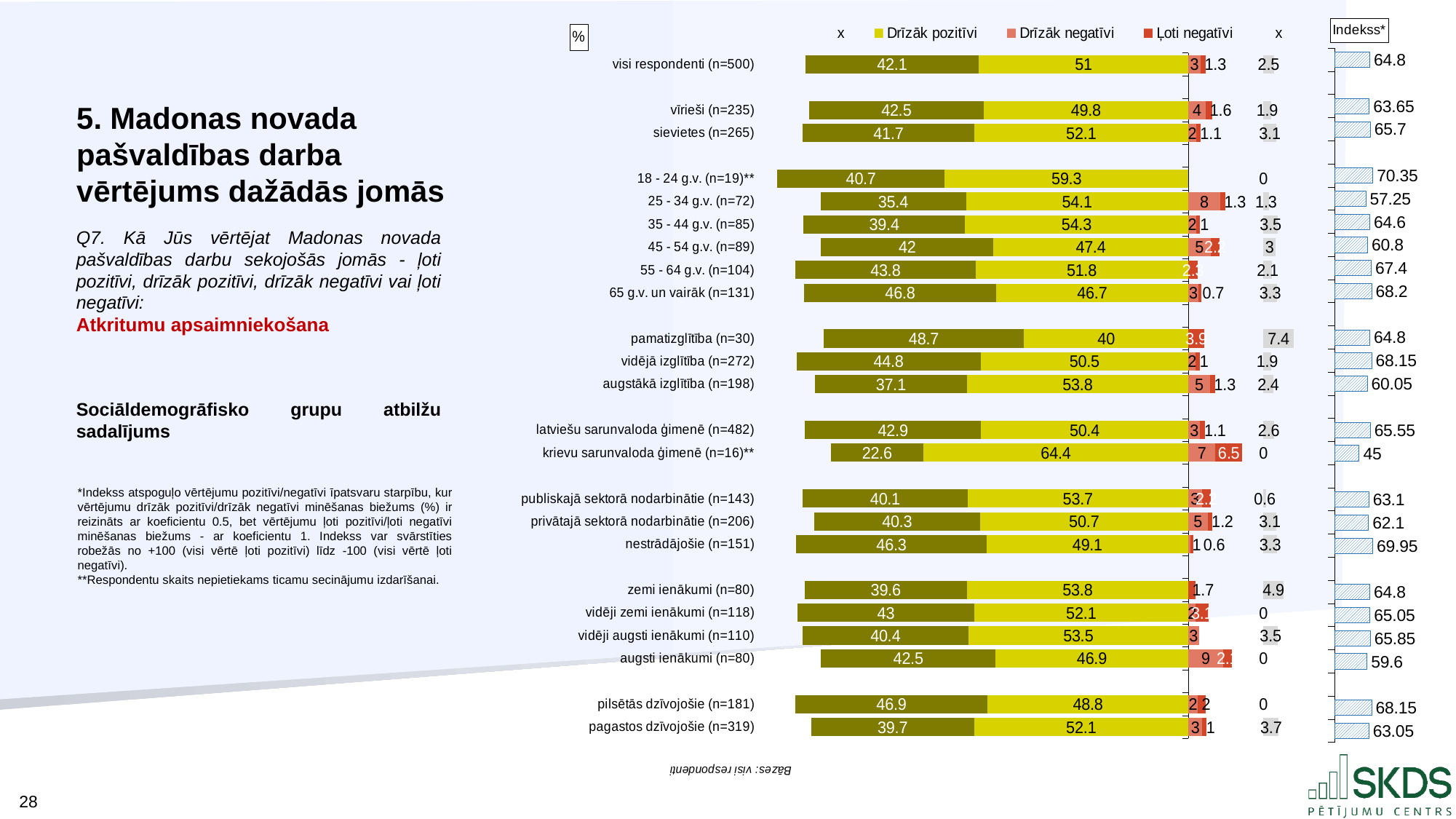
Which group has the highest Indekss* value? 18 - 24 g.v. (n=19)** Which group has the highest 'Drīzāk pozitīvi' value? krievu sarunvaloda ģimenē (n=16)** What type of chart is shown on the slide? Stacked bar chart What is the 'Drīzāk pozitīvi' value for 'visi respondenti (n=500)'? 51 What is the Indekss* value for the '18 - 24 g.v. (n=19)**' group? 70.35 What is the difference between the Indekss* values for 'sievietes (n=265)' and 'vīrieši (n=235)'? 2.05 Which has a higher Indekss* value: 'pilsētās dzīvojošie (n=181)' or 'pagastos dzīvojošie (n=319)'? pilsētās dzīvojošie (n=181) How many respondent groups (bars) are shown in the chart? 23 Which group has the lowest Indekss* value? krievu sarunvaloda ģimenē (n=16)** What is the 'Drīzāk negatīvi' value for '25 - 34 g.v. (n=72)'? 8 What is the value of the dark olive (leftmost) segment for 'nestrādājošie (n=151)'? 46.3 What is the Indekss* value for 'krievu sarunvaloda ģimenē (n=16)**'? 45